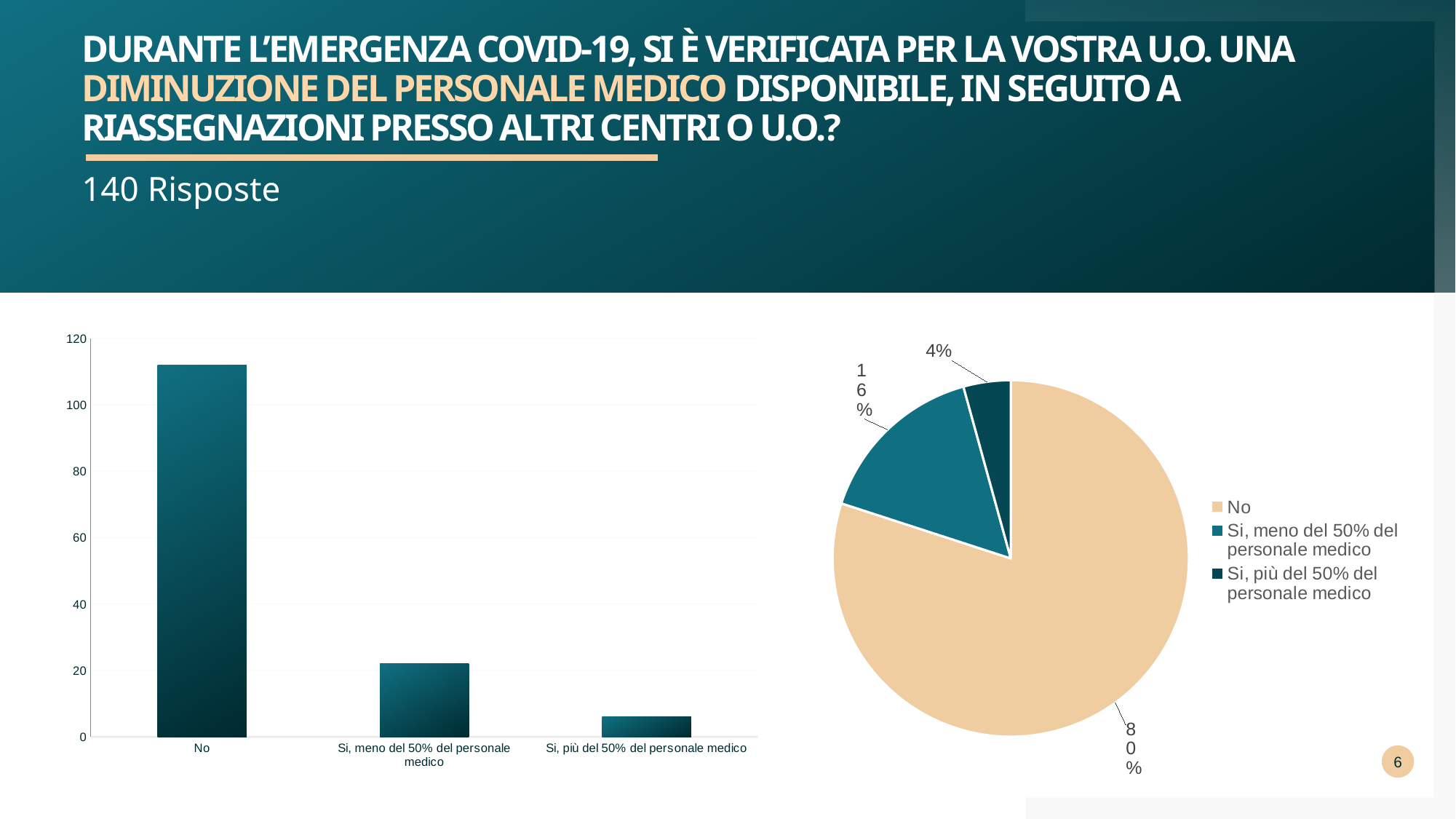
In the bar chart on the left, how many categories are shown on the x axis? 3 In the bar chart on the left, is the value for 'Si, più del 50% del personale medico' greater or less than 20? less In the pie chart on the right, what is the difference in percentage points between the 'No' slice and the 'Si, più del 50% del personale medico' slice? 76 In the bar chart on the left, which category has the lowest bar? Si, più del 50% del personale medico What kind of chart is the chart on the right of the slide? pie chart In the bar chart on the left, is the value for 'No' greater or less than 100? greater In the pie chart on the right, what share does the 'Si, meno del 50% del personale medico' slice represent? 16% What kind of chart is the chart on the left of the slide? bar chart In the bar chart on the left, is the value for 'Si, meno del 50% del personale medico' greater or less than 40? less How many entries does the legend of the pie chart on the right list? 3 In the pie chart on the right, what share does the 'No' slice represent? 80% In the bar chart on the left, which category has the highest bar? No